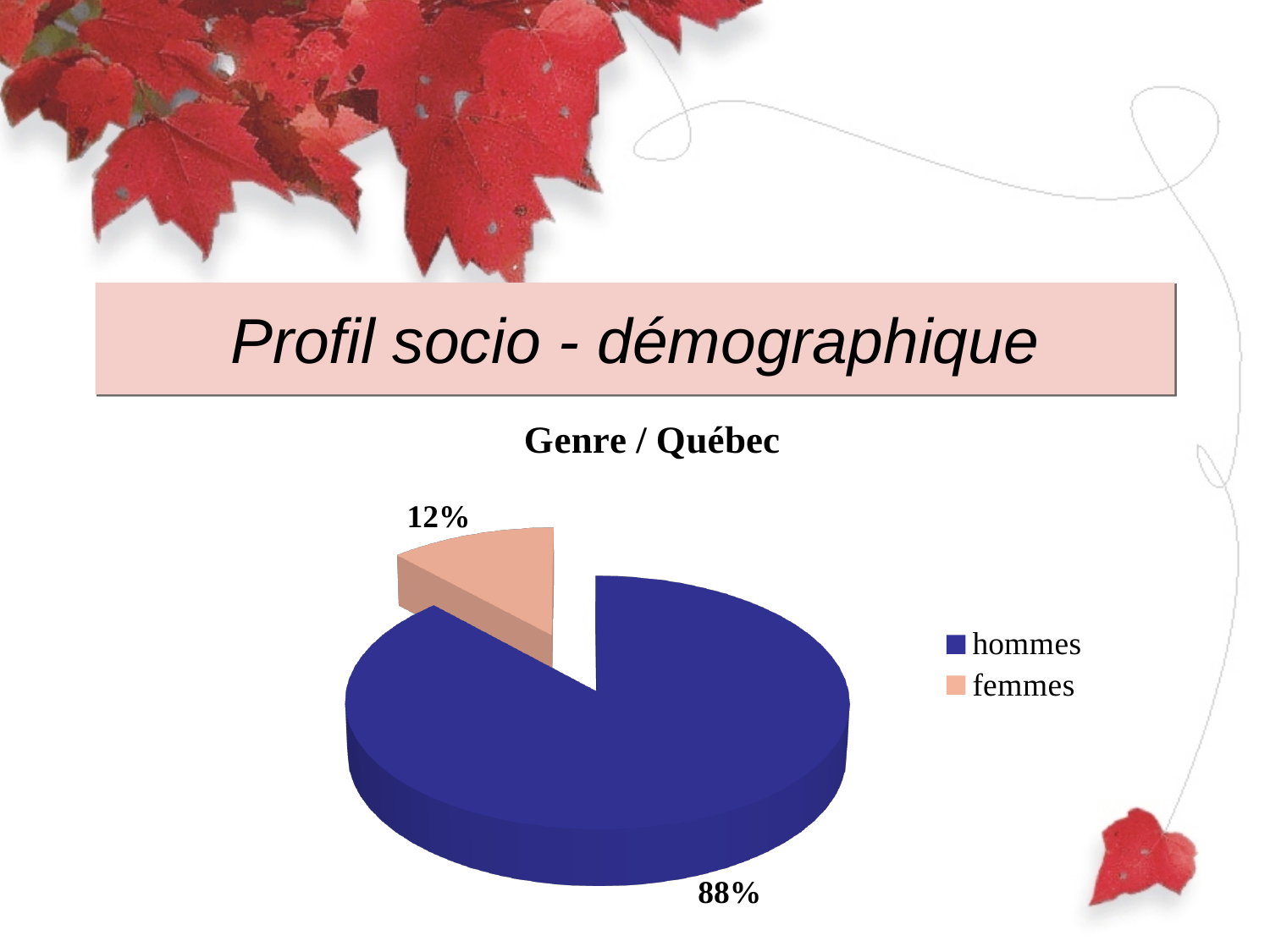
What share of the pie is labelled for femmes? 12% What is the title of the chart? Genre / Québec What kind of chart is shown on the slide? pie chart What colour is the hommes slice? blue How many slices does the pie chart have? 2 Which category has the largest slice of the pie? hommes What is the difference in percentage points between the hommes and femmes slices? 76 Which slice is larger, hommes or femmes? hommes What share of the pie is labelled for hommes? 88% Which category has the smallest slice of the pie? femmes How many entries does the legend list? 2